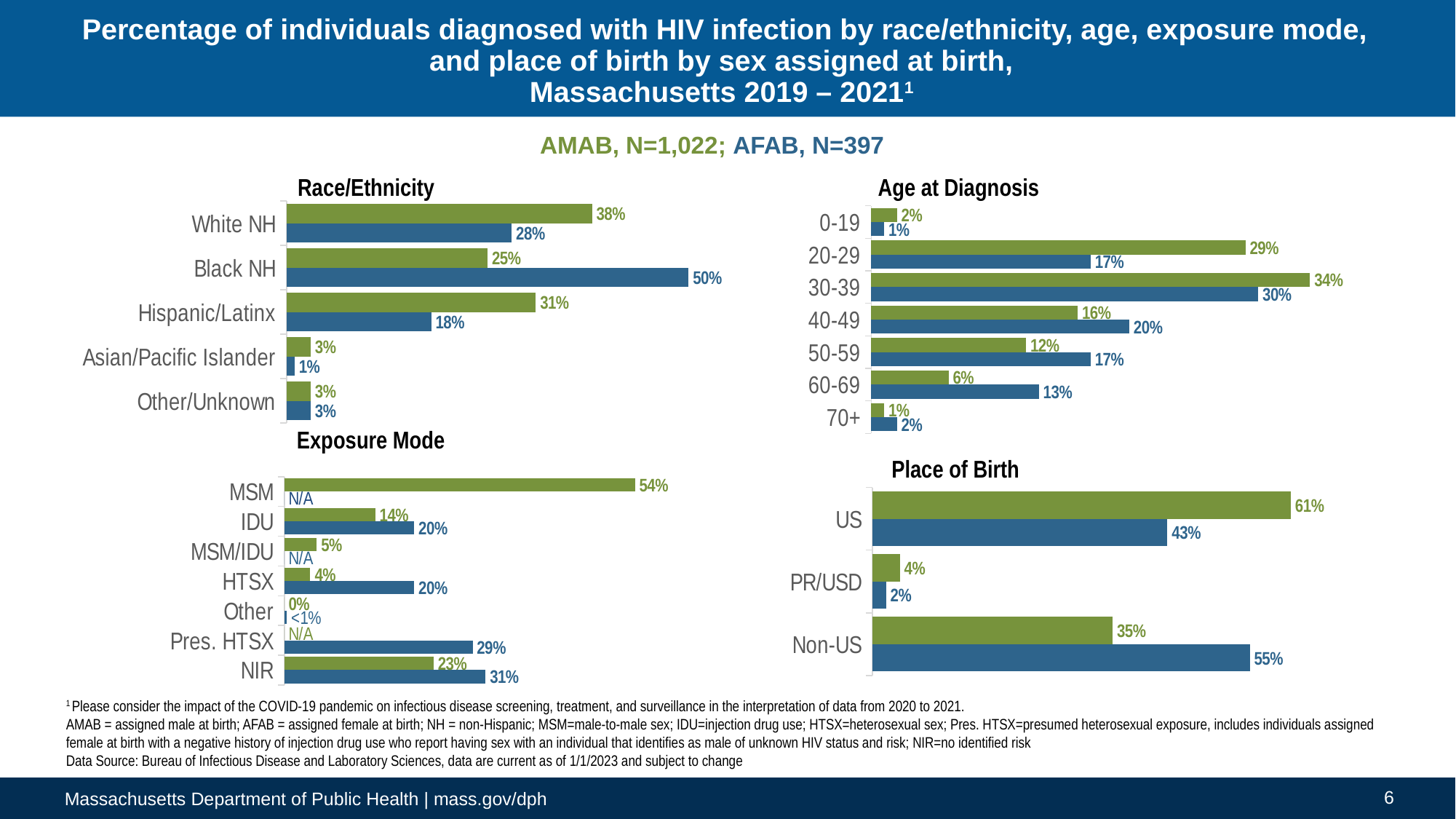
In the Age at Diagnosis chart, which age group has the highest AMAB (green) value? 30-39 In the Place of Birth chart, what is the AFAB (blue) value for Non-US? 55% In the Age at Diagnosis chart, how many age groups are shown? 7 In the Place of Birth chart, what is the difference between the AMAB and AFAB values for US? 18% What type of chart is used for the Place of Birth data? Bar chart In the Race/Ethnicity chart, which category has the highest AFAB (blue) value? Black NH In the Exposure Mode chart, which is larger for NIR: the AMAB value or the AFAB value? AFAB (31%) In the Race/Ethnicity chart, what is the difference between the AMAB and AFAB values for Hispanic/Latinx? 13% In the Race/Ethnicity chart, what is the AFAB (blue) value for Black NH? 50% In the Race/Ethnicity chart, what is the AMAB (green) value for White NH? 38% In the Exposure Mode chart, what is the AMAB (green) value for MSM? 54% In the Age at Diagnosis chart, what is the AFAB (blue) value for 60-69? 13%